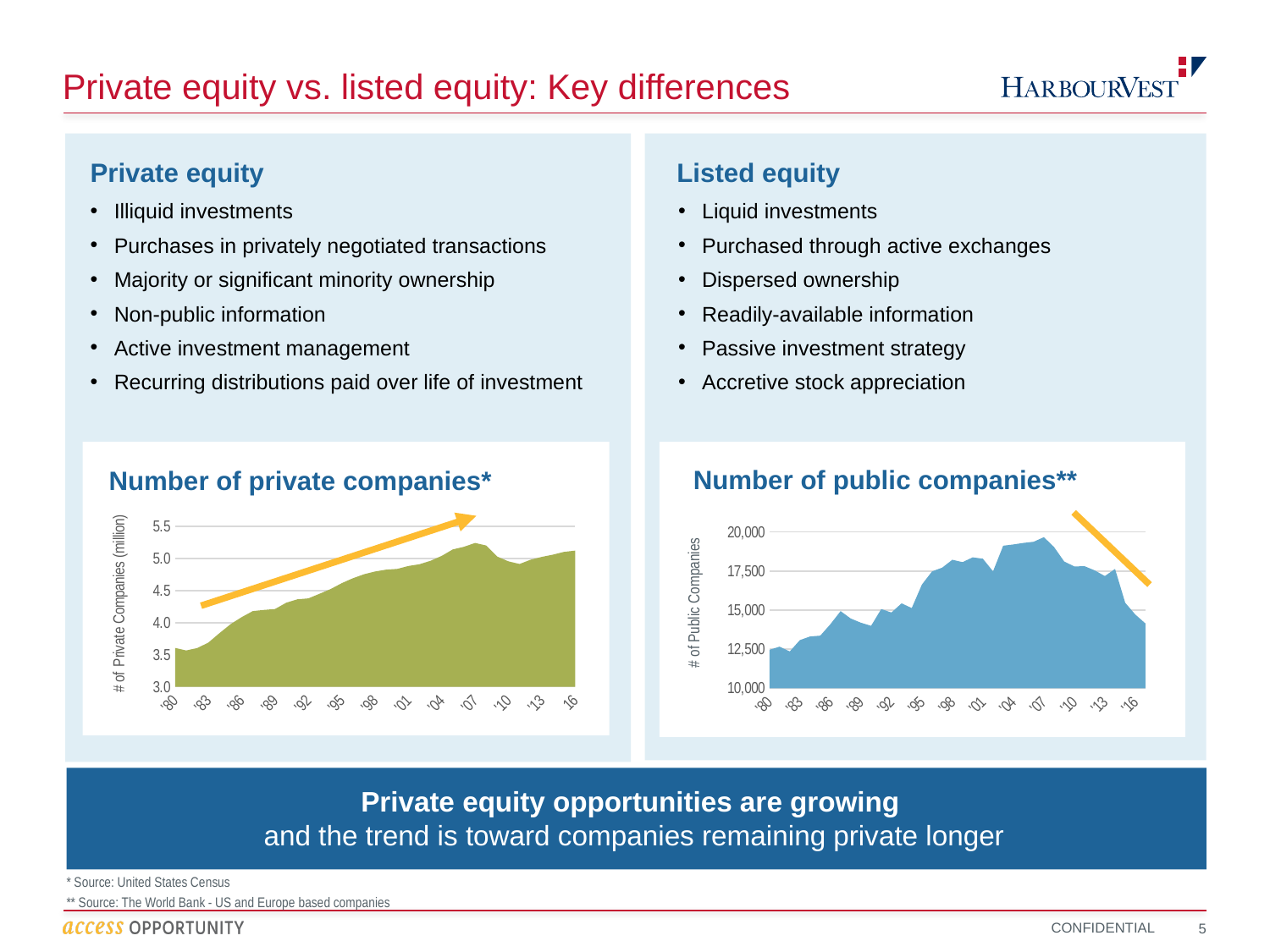
What kind of chart is the 'Number of private companies*' chart? Area chart In the 'Number of public companies**' chart, do the values rise or fall from '10 to '16? Fall In the 'Number of private companies*' chart, which year has the larger value, '80 or '07? '07 In the 'Number of public companies**' chart, is the value for '07 greater or less than 17,500? greater In the 'Number of private companies*' chart, is the value for '83 greater or less than 4.0? less What kind of chart is the 'Number of public companies**' chart? Area chart In the 'Number of private companies*' chart, do the values generally rise or fall from '80 to '16? Rise In the 'Number of private companies*' chart, is the value for '07 greater or less than 5.0? greater What is the y-axis label of the 'Number of public companies**' chart? # of Public Companies In the 'Number of public companies**' chart, which year has the larger value, '07 or '16? '07 What is the y-axis label of the 'Number of private companies*' chart? # of Private Companies (million)